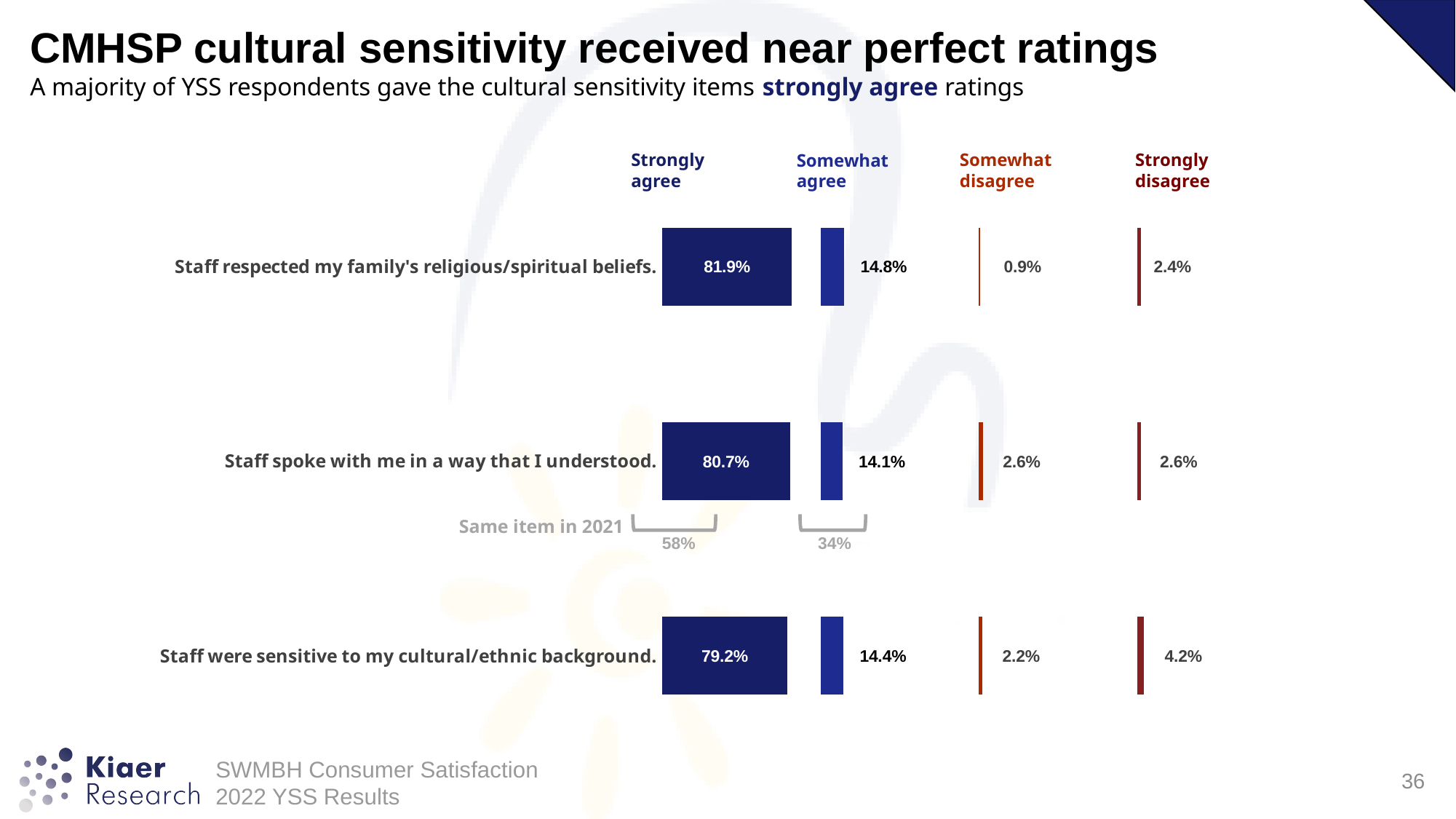
Which is larger: the Strongly disagree value for "Staff were sensitive to my cultural/ethnic background" or for "Staff spoke with me in a way that I understood"? Staff were sensitive to my cultural/ethnic background. What percentage of respondents strongly agreed that staff respected their family's religious/spiritual beliefs? 81.9% Which item has the lowest Somewhat disagree percentage? Staff respected my family's religious/spiritual beliefs. How many survey items are shown in the chart? 3 What was the Strongly agree value for "Staff spoke with me in a way that I understood" in 2021? 58% What type of chart is shown on the slide? Bar chart How much did the Strongly agree value for "Staff spoke with me in a way that I understood" increase from 2021 (58%) to the current result? 22.7% What is the Strongly disagree value for "Staff were sensitive to my cultural/ethnic background"? 4.2% What is the difference between the Strongly agree values for "Staff respected my family's religious/spiritual beliefs" and "Staff were sensitive to my cultural/ethnic background"? 2.7% Which item has the highest Strongly agree percentage? Staff respected my family's religious/spiritual beliefs. What is the Somewhat agree value for "Staff spoke with me in a way that I understood"? 14.1% How many response categories are shown across the top of the chart? 4